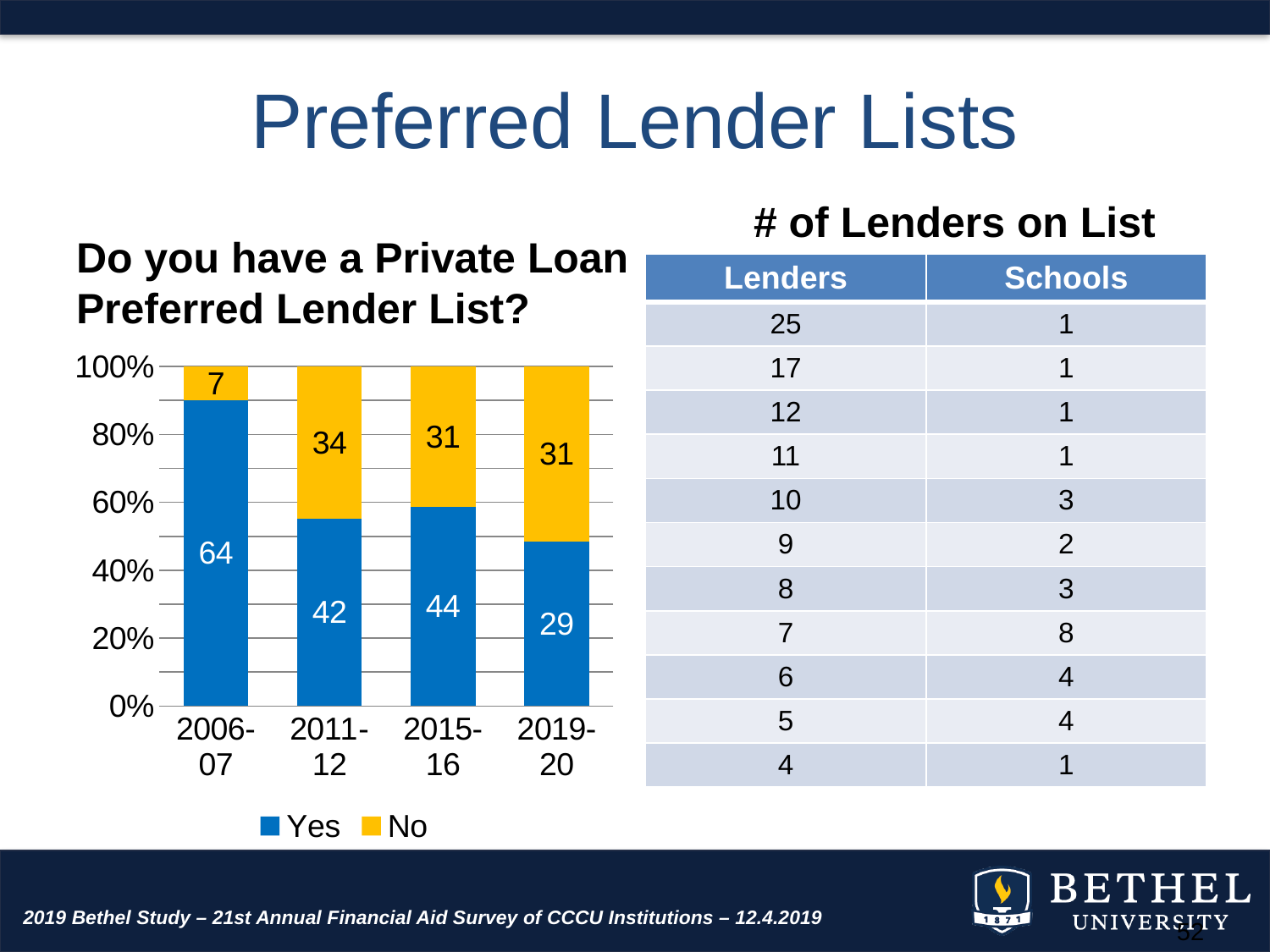
What is the difference between the "Yes" values for 2006-07 and 2019-20? 35 How many series does the chart's legend list? 2 How many periods are shown on the x axis of the chart? 4 In which period is the "No" value lowest? 2006-07 What is the value for "Yes" in 2019-20? 29 What is the value for "No" in 2011-12? 34 What is the value for "No" in 2015-16? 31 What kind of chart is shown on the slide? Stacked bar chart What is the total of the "Yes" and "No" values for 2019-20? 60 In which period is the "Yes" value highest? 2006-07 What is the value for "Yes" in 2006-07? 64 Which is larger, the "Yes" value for 2011-12 or the "Yes" value for 2015-16? 2015-16